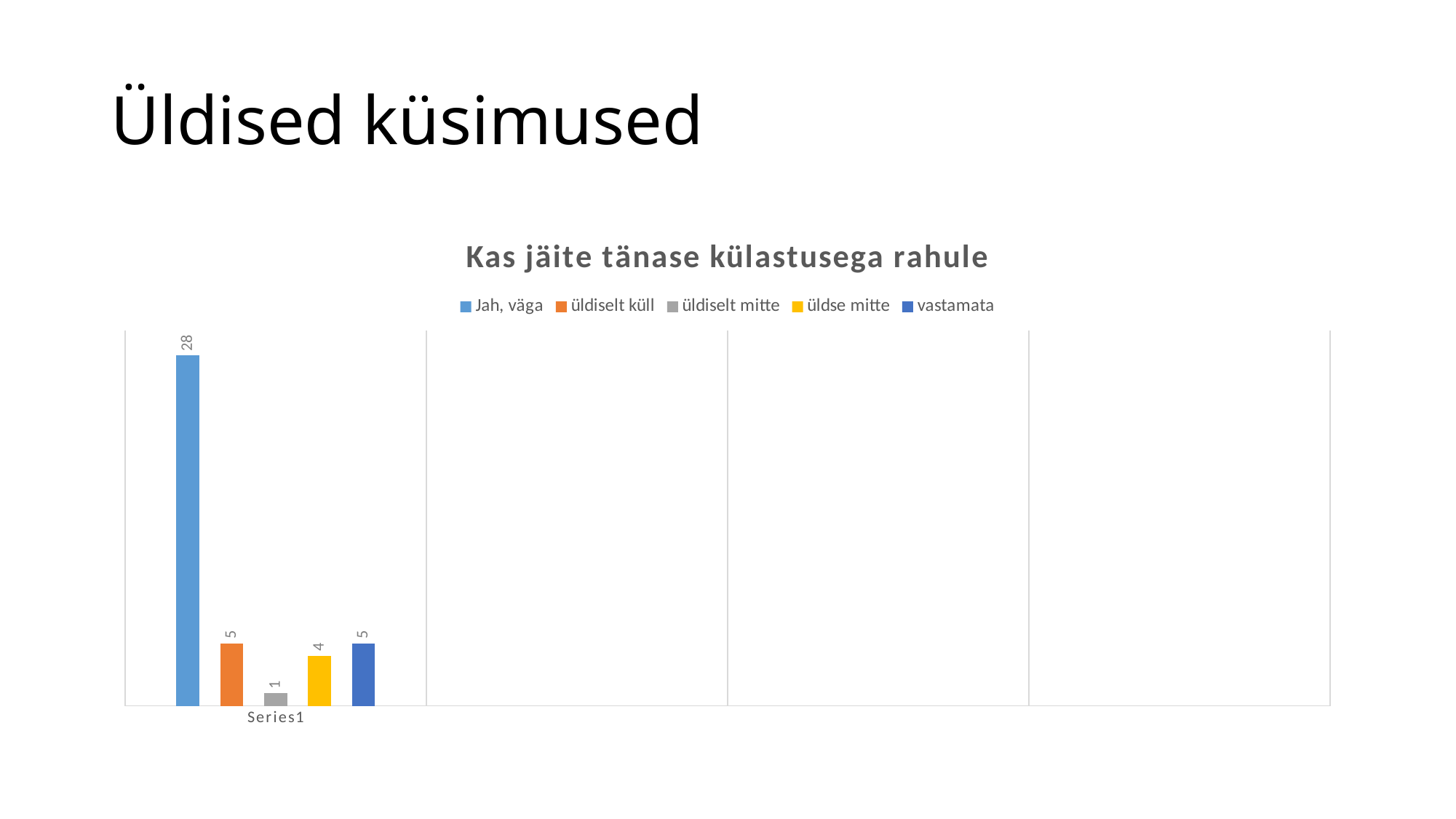
What is the value for "üldiselt küll"? 5 What is the value for "üldse mitte"? 4 What is the value for "Jah, väga"? 28 What is the title of the chart? Kas jäite tänase külastusega rahule What is the value for "vastamata"? 5 How many series does the legend list? 5 What is the difference between the values for "Jah, väga" and "üldiselt küll"? 23 Which series has the highest value? Jah, väga Which is larger, the value for "üldse mitte" or the value for "üldiselt mitte"? üldse mitte What is the value for "üldiselt mitte"? 1 What type of chart is shown on the slide? bar chart Which series has the lowest value? üldiselt mitte